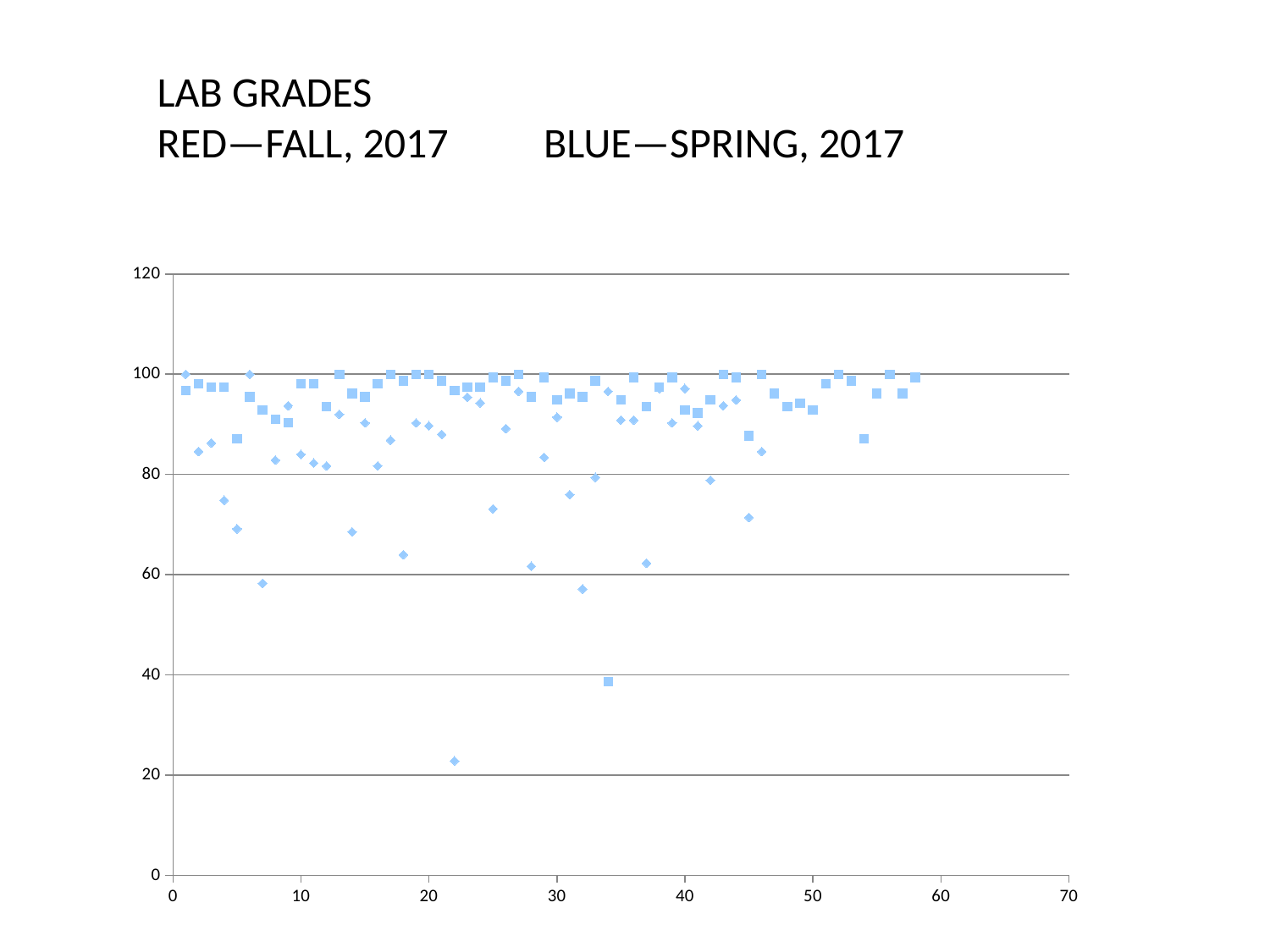
Is the lowest plotted value on the chart greater or less than 40? less According to the slide text, which semester does the blue series represent? Spring, 2017 Is the value of the point at x = 1 greater or less than 80? greater What kind of chart is shown on the slide? scatter chart Is the value of the square point at x = 34 greater or less than 60? less What is the title of the chart on the slide? LAB GRADES